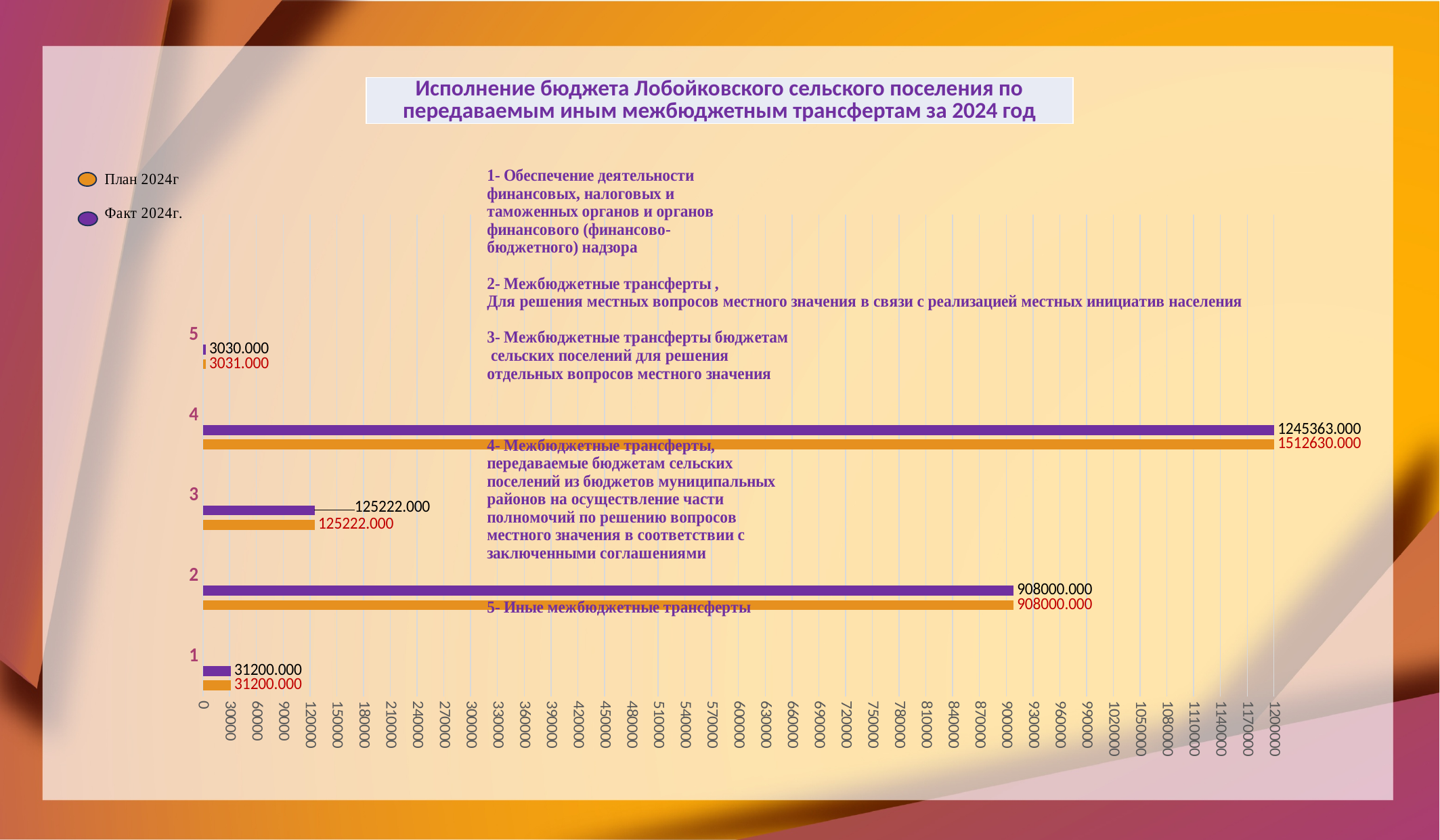
What is the difference between the План 2024г and Факт 2024г. values for category 4? 267267.000 Which category has the highest Факт 2024г. value? 4 What kind of chart is shown on the slide? bar chart How many categories are plotted on the chart? 5 Which has the larger Факт 2024г. value, category 2 or category 3? category 2 What is the План 2024г value for category 1? 31200.000 What colour represents План 2024г in the legend? orange What is the План 2024г value for category 4? 1512630.000 What is the Факт 2024г. value for category 2? 908000.000 What is the Факт 2024г. value for category 4? 1245363.000 How many series does the legend list? 2 Which category has the lowest План 2024г value? 5